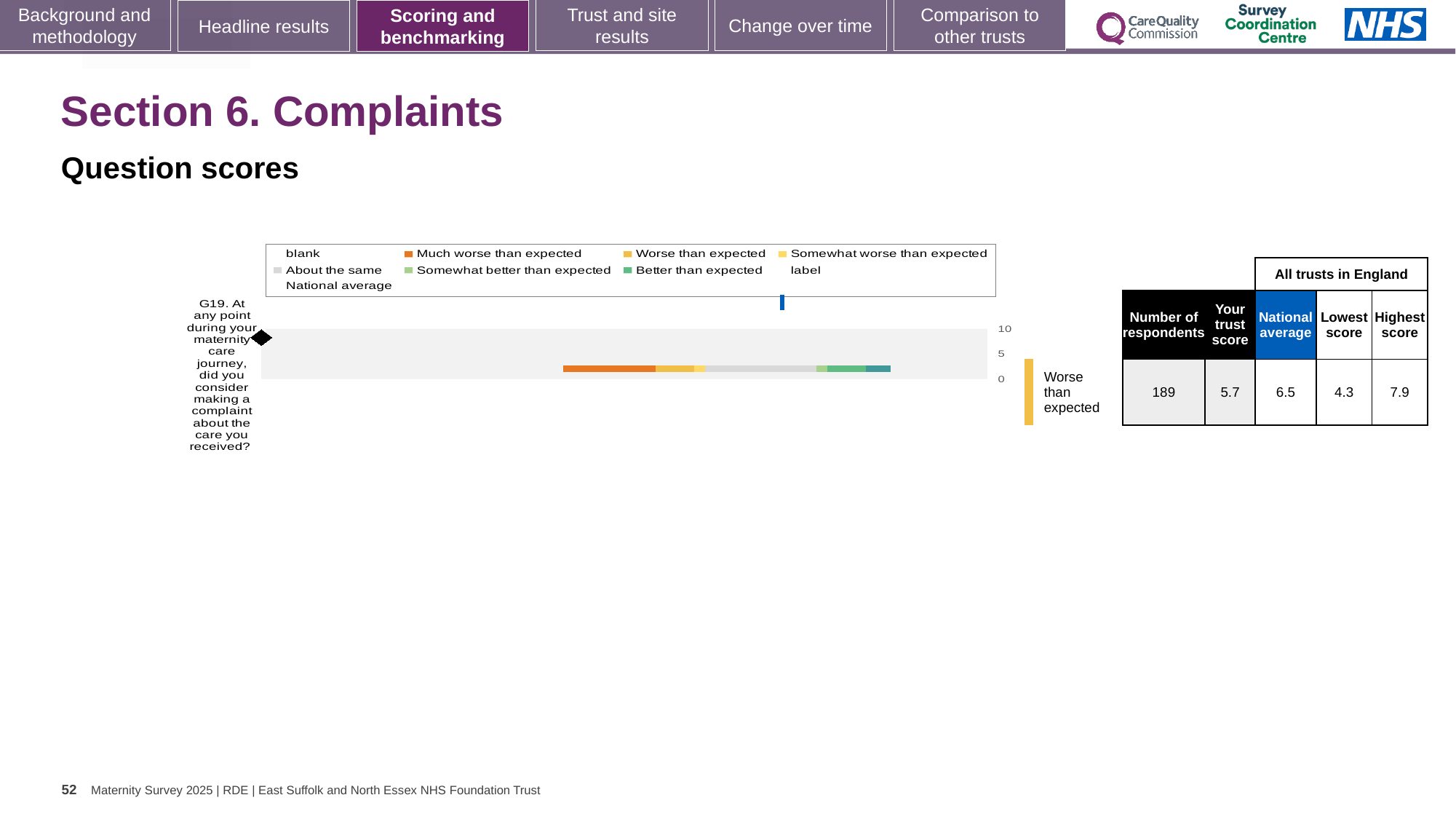
What is the trust score for question G19? 5.7 What is the difference between the national average and the trust score for question G19? 0.8 What is the national average score for question G19? 6.5 Which question is plotted on the chart? G19. At any point during your maternity care journey, did you consider making a complaint about the care you received? How many survey questions are plotted on the chart? 1 How many respondents answered question G19? 189 What is the lowest score among all trusts in England for question G19? 4.3 What is the difference between the highest and lowest scores among all trusts in England for question G19? 3.6 Which is larger for question G19, the trust score or the national average? National average What is the highest score among all trusts in England for question G19? 7.9 What kind of chart is used to show the G19 question score? bar chart What benchmark rating is shown for question G19? Worse than expected